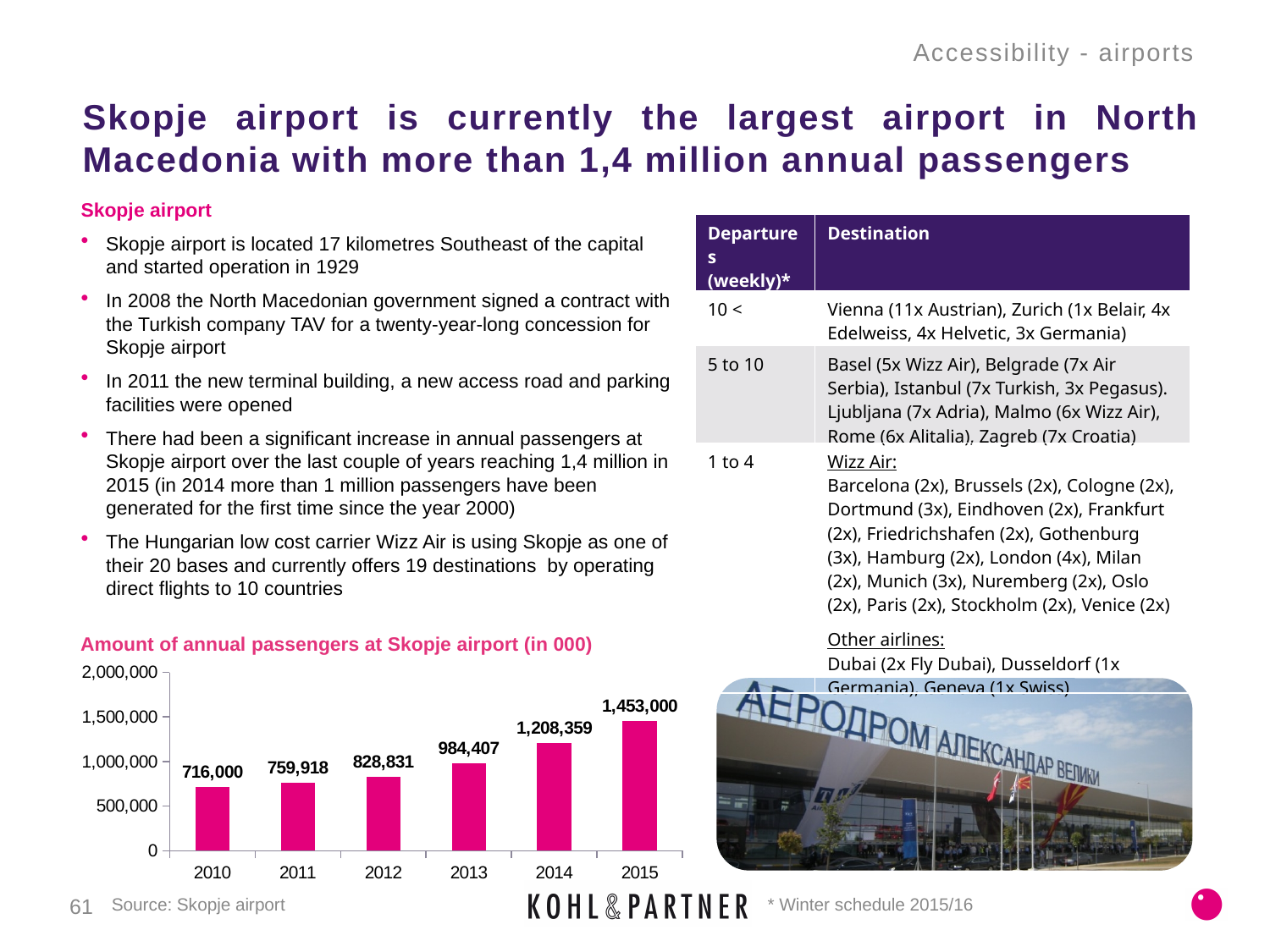
Is the value for 2014 in the chart of annual passengers at Skopje airport greater or less than 1,000,000? greater What is the difference between the 2011 and 2010 values in the chart of annual passengers at Skopje airport? 43,918 What is the value for 2015 in the chart of annual passengers at Skopje airport? 1,453,000 Which year has the highest value in the chart of annual passengers at Skopje airport? 2015 What kind of chart is used to show annual passengers at Skopje airport? Bar chart Which is larger in the chart of annual passengers at Skopje airport, the value for 2012 or the value for 2013? 2013 What is the difference between the 2015 and 2014 values in the chart of annual passengers at Skopje airport? 244,641 Which year has the lowest value in the chart of annual passengers at Skopje airport? 2010 What is the value for 2013 in the chart of annual passengers at Skopje airport? 984,407 How many years are shown in the chart of annual passengers at Skopje airport? 6 What is the value for 2010 in the chart of annual passengers at Skopje airport? 716,000 Do the values in the chart of annual passengers at Skopje airport rise or fall from 2010 to 2015? Rise